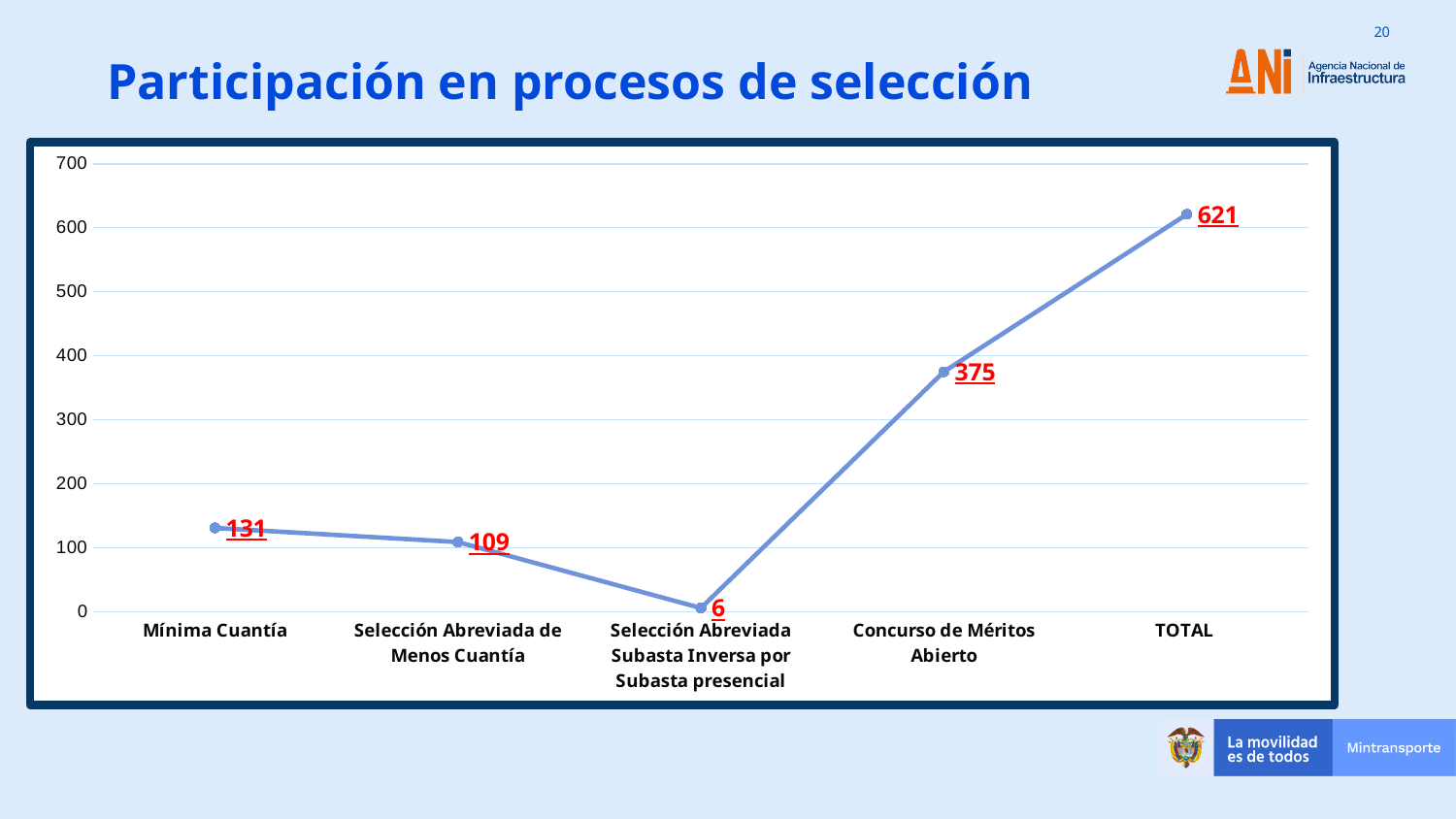
How many categories are shown on the x axis? 5 Which category has the lowest value? Selección Abreviada Subasta Inversa por Subasta presencial What is the value for Selección Abreviada de Menos Cuantía? 109 What is the value for Mínima Cuantía? 131 What is the title of the slide? Participación en procesos de selección What is the difference between the values for Concurso de Méritos Abierto and Mínima Cuantía? 244 Excluding TOTAL, which category has the highest value? Concurso de Méritos Abierto What is the value for Concurso de Méritos Abierto? 375 What is the value for TOTAL? 621 What kind of chart is shown on the slide? Line chart Which is larger, the value for Mínima Cuantía or the value for Selección Abreviada de Menos Cuantía? Mínima Cuantía What is the value for Selección Abreviada Subasta Inversa por Subasta presencial? 6